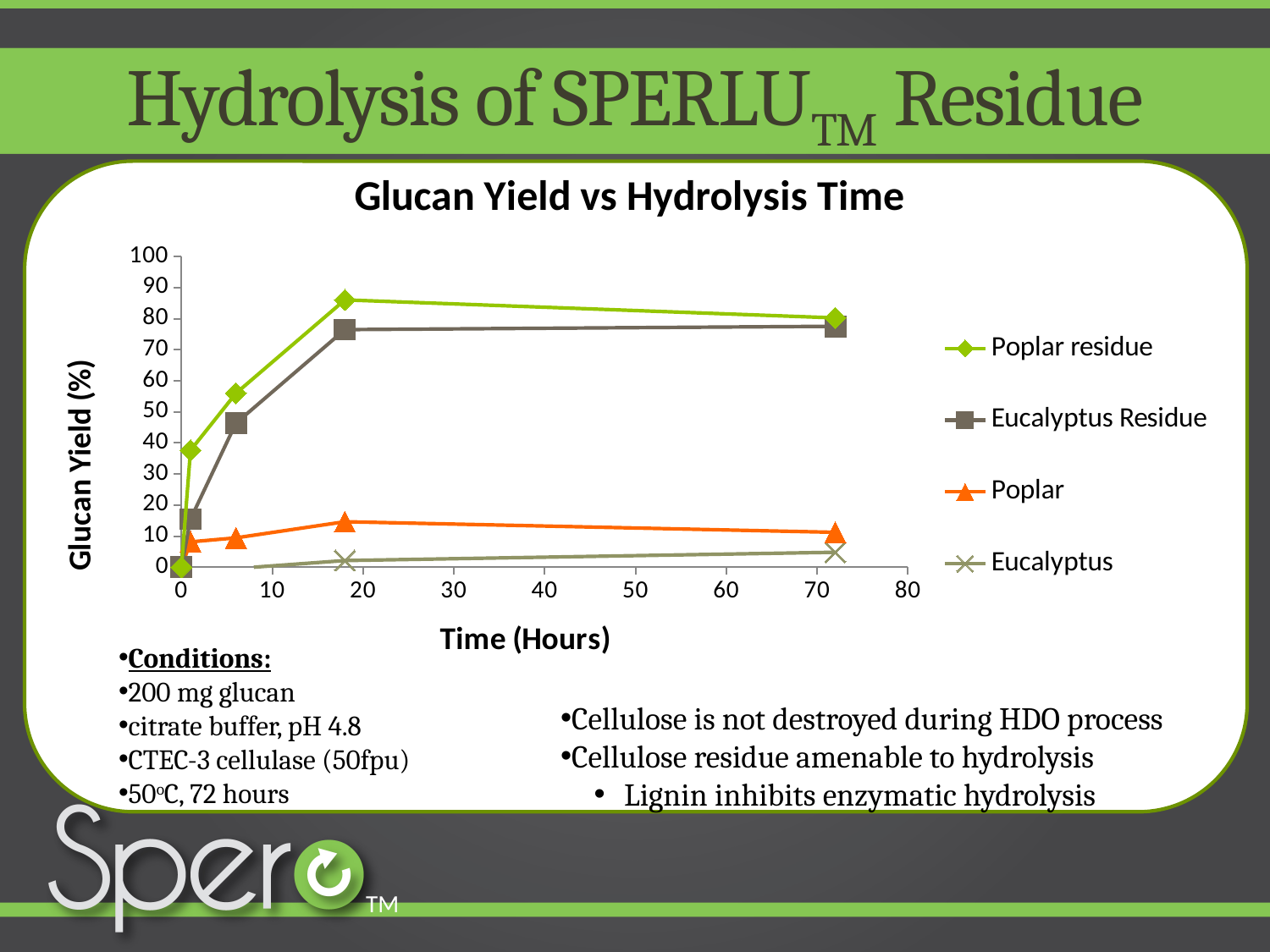
What is the label of the y axis? Glucan Yield (%) Which series reaches the highest glucan yield? Poplar residue Does the glucan yield for Eucalyptus Residue rise or fall between 0 and 20 hours? Rise At around 18 hours, which has the higher glucan yield, Poplar residue or Poplar? Poplar residue What is the title of the chart? Glucan Yield vs Hydrolysis Time Is the glucan yield for Eucalyptus at around 72 hours greater or less than 10? less Is the glucan yield for Eucalyptus Residue at around 72 hours greater or less than 70? greater Which series has the lowest glucan yield across the hydrolysis time? Eucalyptus What kind of chart is shown on the slide? Line chart Is the glucan yield for Poplar at around 18 hours greater or less than 30? less How many series does the legend list? 4